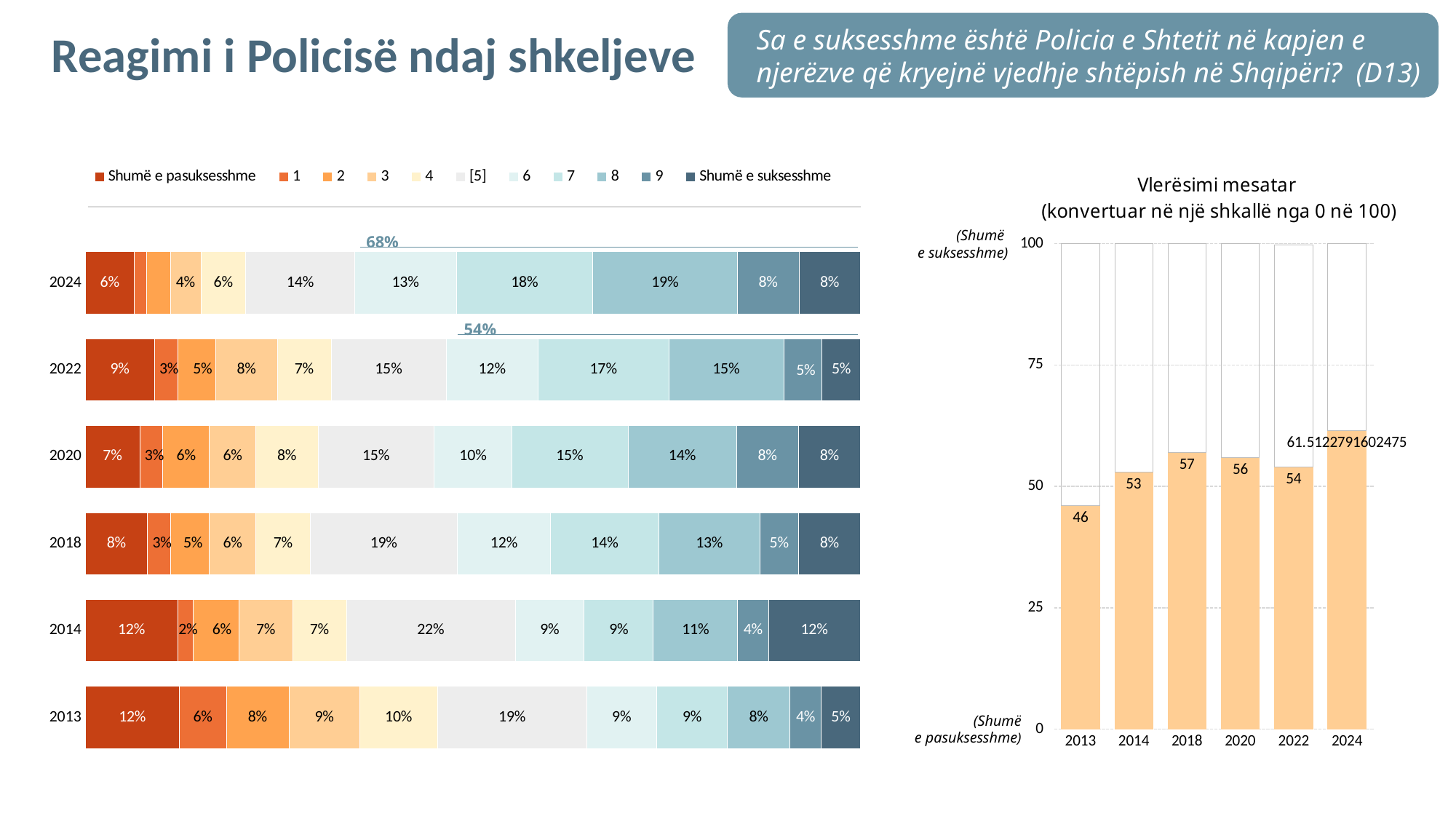
In the chart titled 'Vlerësimi mesatar', what is the value for 2018? 57 In the chart titled 'Vlerësimi mesatar', what is the difference between the values for 2018 and 2013? 11 In the chart titled 'Vlerësimi mesatar', which year has the lowest value? 2013 In the chart titled 'Vlerësimi mesatar', which year has the highest value? 2024 In the stacked bar chart on the left, what is the value of the '[5]' segment for 2014? 22% In the chart titled 'Vlerësimi mesatar', is the value for 2022 greater or less than 50? greater What kind of chart is the chart titled 'Vlerësimi mesatar'? bar chart In the chart titled 'Vlerësimi mesatar', how many years are shown on the x axis? 6 In the stacked bar chart on the left, how many series does the legend list? 11 In the stacked bar chart on the left, which year has the larger 'Shumë e pasuksesshme' segment, 2013 or 2024? 2013 In the chart titled 'Vlerësimi mesatar', what is the value for 2013? 46 In the stacked bar chart on the left, what is the value of the 'Shumë e suksesshme' segment for 2024? 8%